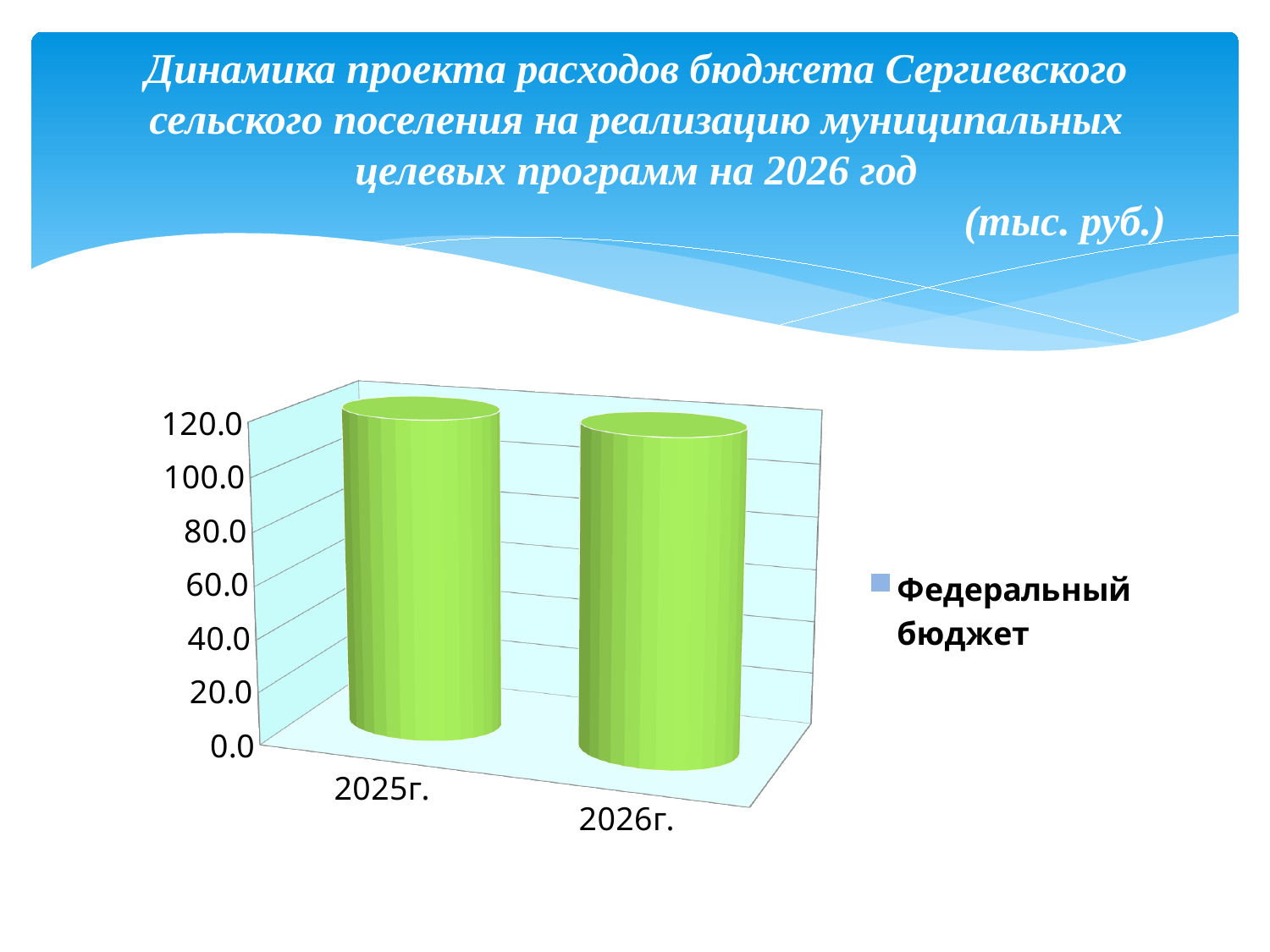
Is the value for 2025г. greater or less than 80.0? greater How many categories are shown on the x axis of the chart? 2 Is the value for 2026г. greater or less than 100.0? greater How many series does the chart legend list? 1 What kind of chart is shown on the slide? bar chart Is the value for 2025г. greater or less than 100.0? greater What is the highest tick value shown on the vertical axis of the chart? 120.0 What is the name of the series listed in the chart legend? Федеральный бюджет What are the two categories shown on the x axis of the chart? 2025г. and 2026г.